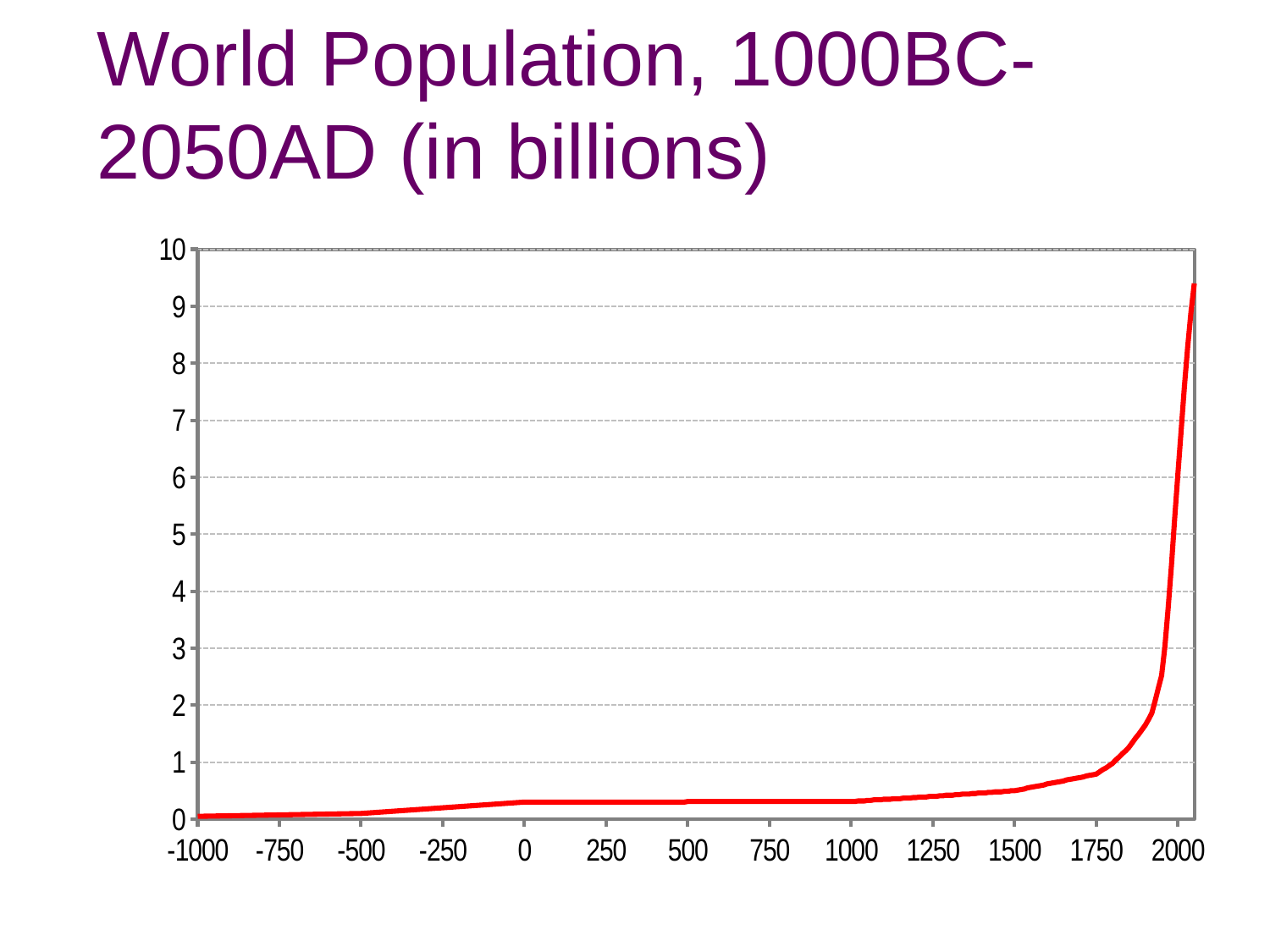
Does the world population rise or fall as the years increase along the x axis? rise What kind of chart is shown on the slide? line chart Is the value for the year 1000 greater or less than 1? less How many labelled tick marks are on the x axis? 13 Is the value for the year 1500 greater or less than 1? less What is the title of the chart? World Population, 1000BC-2050AD (in billions) Is the value at the right end of the line (2050) greater or less than 8? greater Is the line at its highest at the left end or the right end of the x axis? right end What colour is the plotted line? red